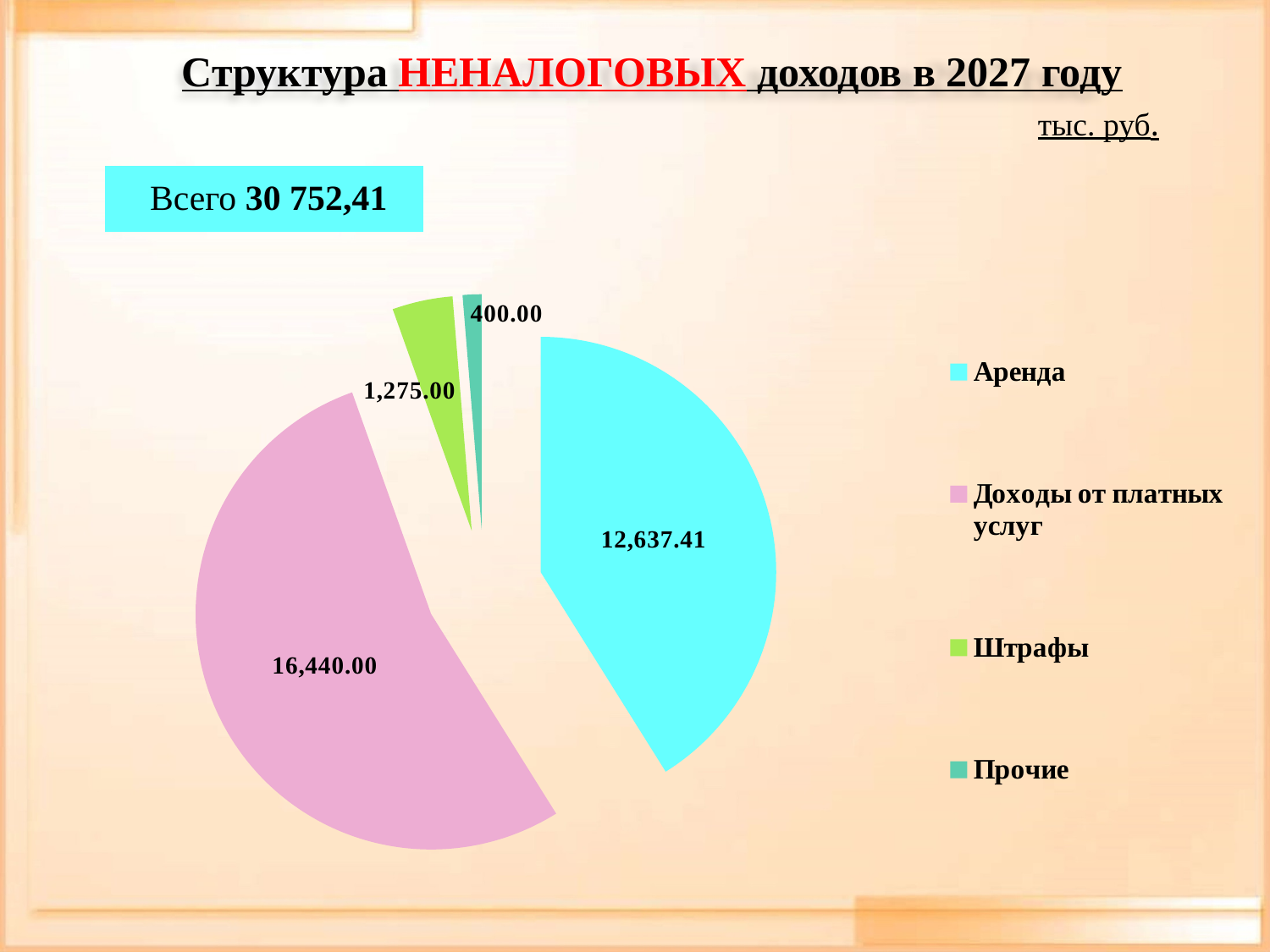
Which category has the largest slice of the pie? Доходы от платных услуг Which is larger, the value for Аренда or the value for Штрафы? Аренда How many categories does the pie chart show? 4 What is the difference between the values for Доходы от платных услуг and Аренда? 3,802.59 What is the value for Штрафы? 1,275.00 Which category has the smallest slice of the pie? Прочие What total value is shown on the slide for all non-tax revenues? 30 752,41 What is the value for Прочие? 400.00 What is the value for Аренда? 12,637.41 What is the value for Доходы от платных услуг? 16,440.00 What is the difference between the values for Штрафы and Прочие? 875.00 What type of chart is shown on the slide? Pie chart